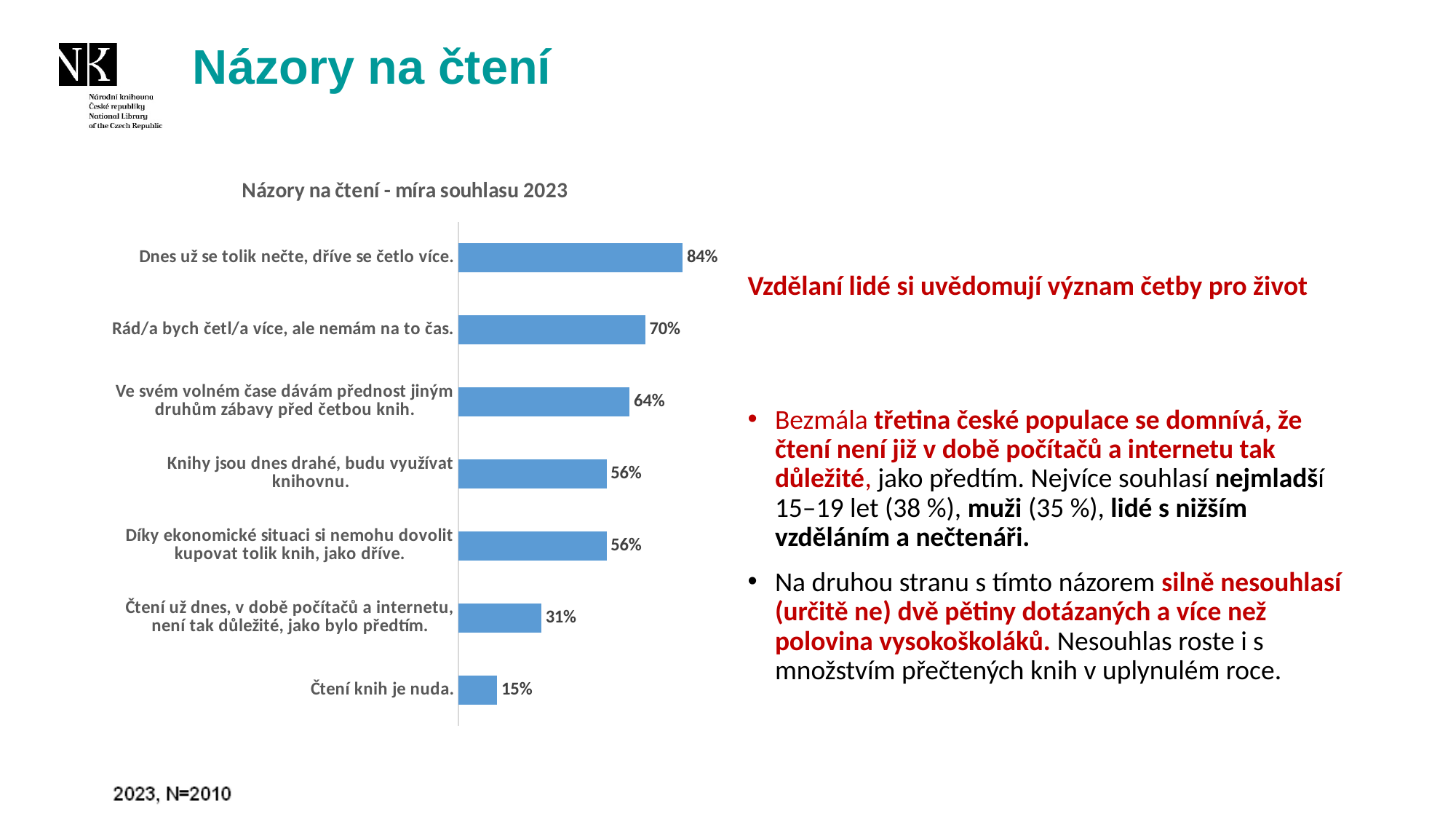
What kind of chart is shown on the slide? Bar chart What is the title of the chart? Názory na čtení - míra souhlasu 2023 How many statements are shown in the chart? 7 Which is larger: the value for "Ve svém volném čase dávám přednost jiným druhům zábavy před četbou knih." or for "Knihy jsou dnes drahé, budu využívat knihovnu."? Ve svém volném čase dávám přednost jiným druhům zábavy před četbou knih. What is the value for "Čtení už dnes, v době počítačů a internetu, není tak důležité, jako bylo předtím."? 31% What is the difference between the values for "Čtení už dnes, v době počítačů a internetu, není tak důležité, jako bylo předtím." and "Čtení knih je nuda."? 16% Which statement has the highest level of agreement? Dnes už se tolik nečte, dříve se četlo více. What is the value for "Dnes už se tolik nečte, dříve se četlo více."? 84% Which statement has the lowest level of agreement? Čtení knih je nuda. What is the value for "Rád/a bych četl/a více, ale nemám na to čas."? 70% What is the value for "Čtení knih je nuda."? 15% What is the difference between the values for "Dnes už se tolik nečte, dříve se četlo více." and "Rád/a bych četl/a více, ale nemám na to čas."? 14%